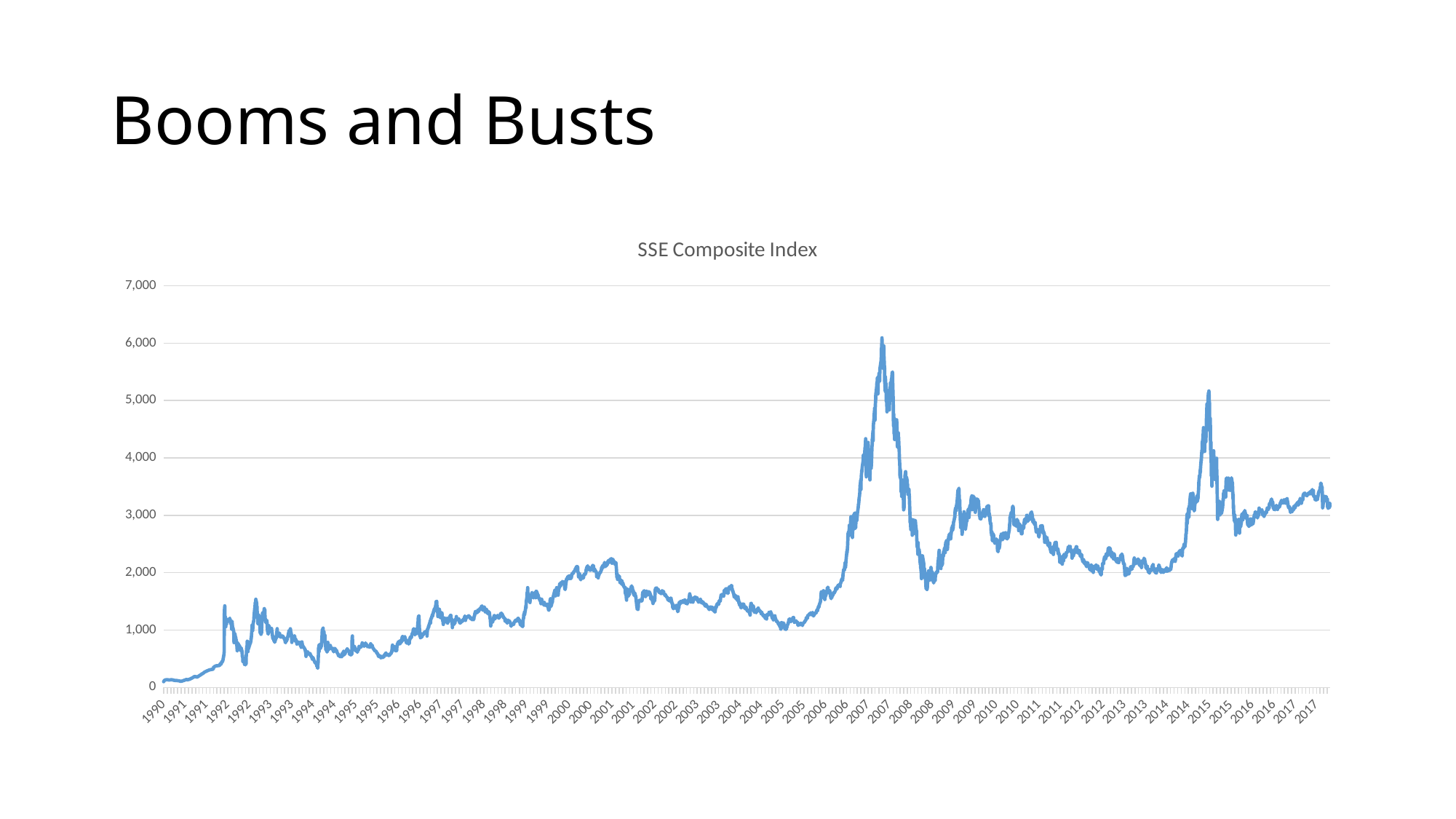
Is the peak value of the index in 2015 greater or less than 6,000? less Is the lowest value of the index in 2005 greater or less than 2,000? less Is the peak value of the index in 2015 greater or less than 4,000? greater In which year does the SSE Composite Index reach its highest value on the chart? 2007 What is the highest value shown on the y axis? 7,000 What is the title of the chart? SSE Composite Index Does the index rise or fall from its 2007 peak into 2008? fall Which peak is higher, the one in 2007 or the one in 2015? 2007 What kind of chart is shown on the slide? line chart Does the index overall rise or fall from 1990 to 2017? rise